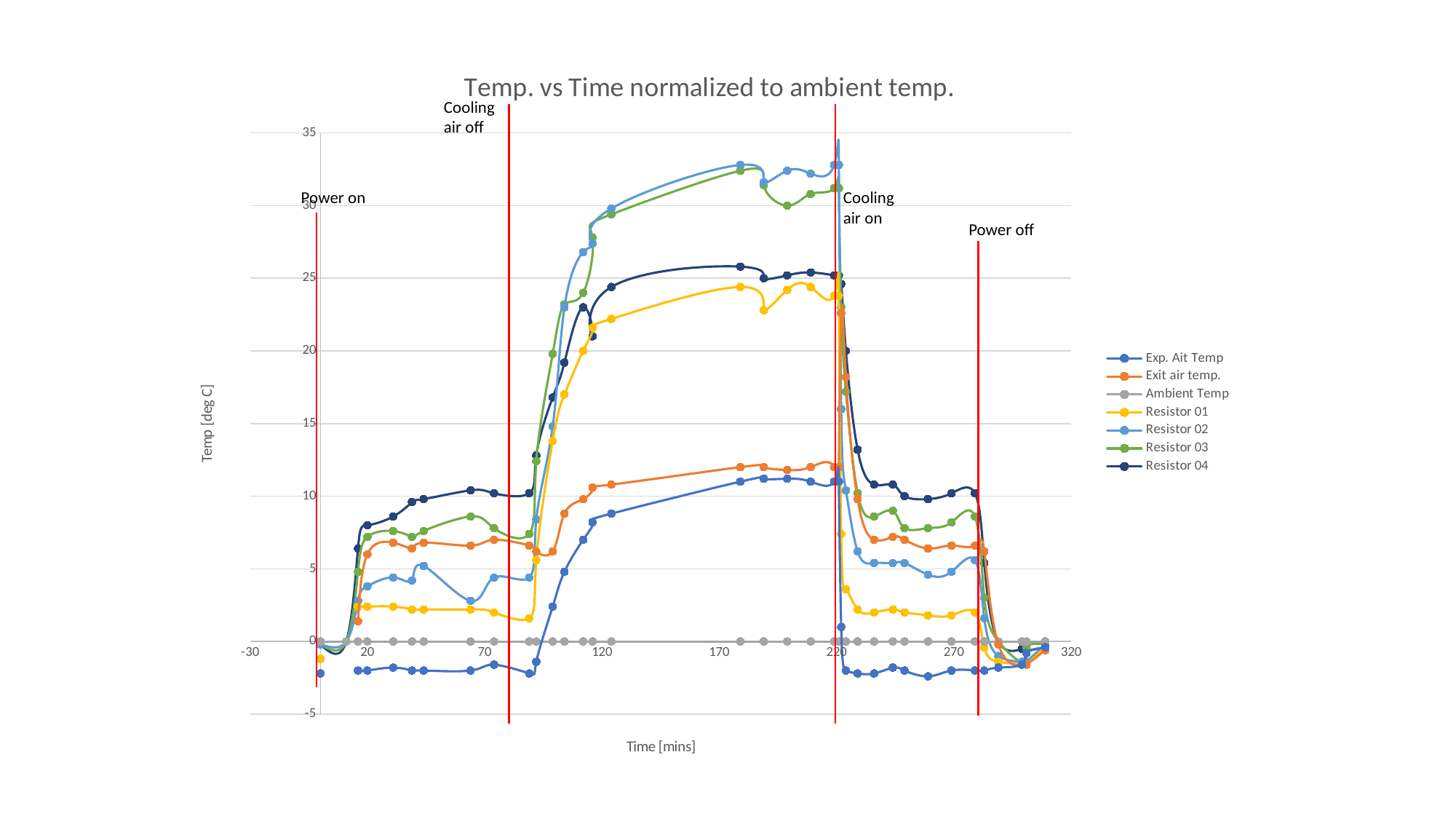
What kind of chart is shown on the slide? line chart Between about 70 and 120 mins, do the Resistor series rise or fall? rise What event label is placed at the red vertical line near 220 mins? Cooling air on What value does the Ambient Temp series hold throughout the chart? 0 Is the value for Resistor 02 at around 170 mins greater or less than 30? greater What is the title of the chart? Temp. vs Time normalized to ambient temp. Which series has the lowest values on the chart? Exp. Ait Temp Is the value for Exp. Ait Temp at around 170 mins greater or less than 15? less Is the value for Resistor 01 at around 170 mins greater or less than 20? greater How many series does the legend list? 7 At around 170 mins, which is higher, Resistor 02 or Resistor 04? Resistor 02 Which series reaches the highest value on the chart? Resistor 02